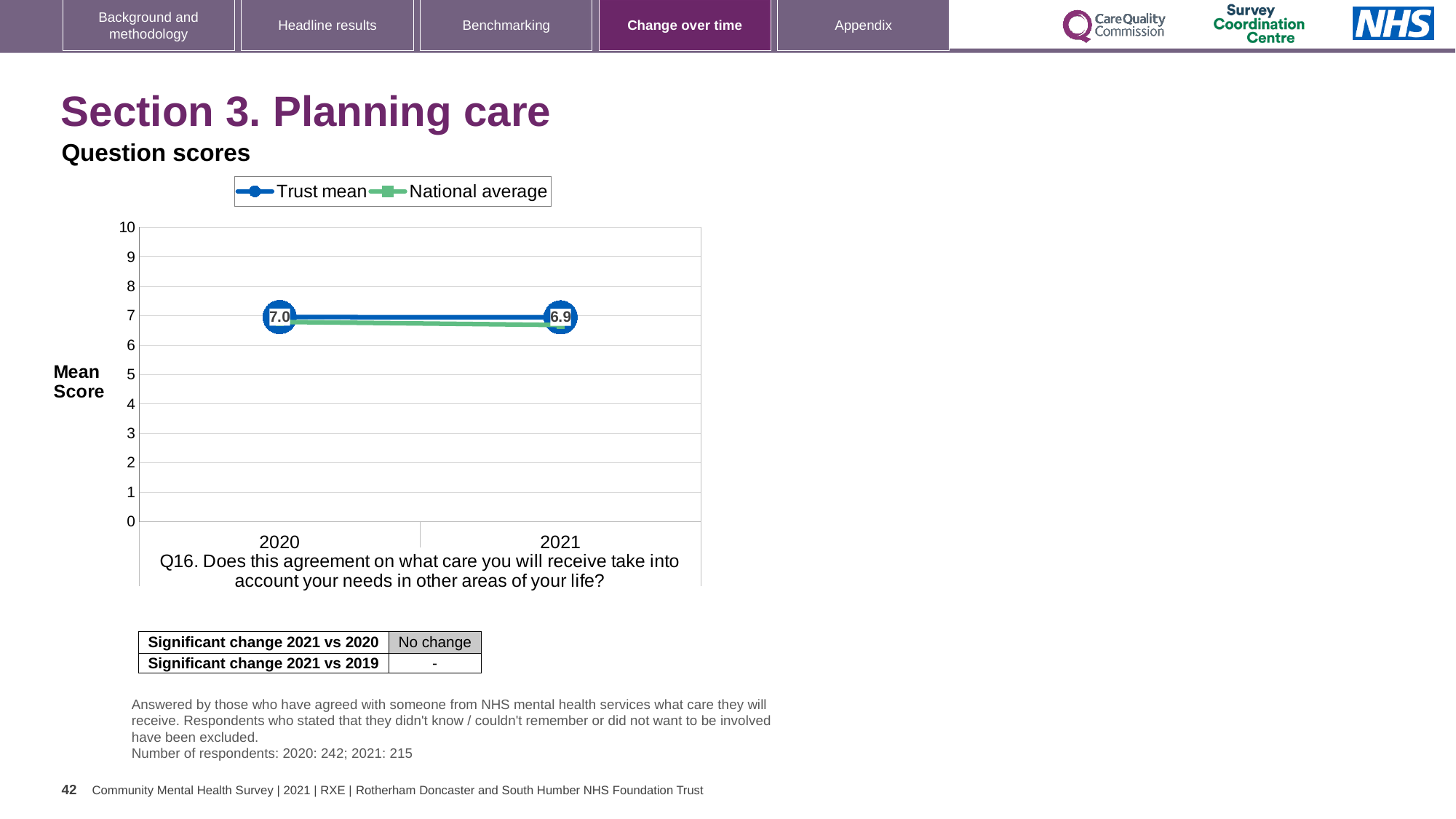
Which year has the higher Trust mean score, 2020 or 2021? 2020 What are the two series named in the chart legend? Trust mean and National average What is the label on the y axis of the chart? Mean Score How many series does the chart legend list? 2 What is the Trust mean score for 2021? 6.9 How many years are plotted on the x axis of the chart? 2 Is the National average value for 2021 greater or less than 8? less Is the National average value for 2020 greater or less than 5? greater Does the Trust mean score rise or fall from 2020 to 2021? Fall What is the Trust mean score for 2020? 7.0 What kind of chart is shown on the slide? Line chart By how much did the Trust mean score change between 2020 and 2021? 0.1